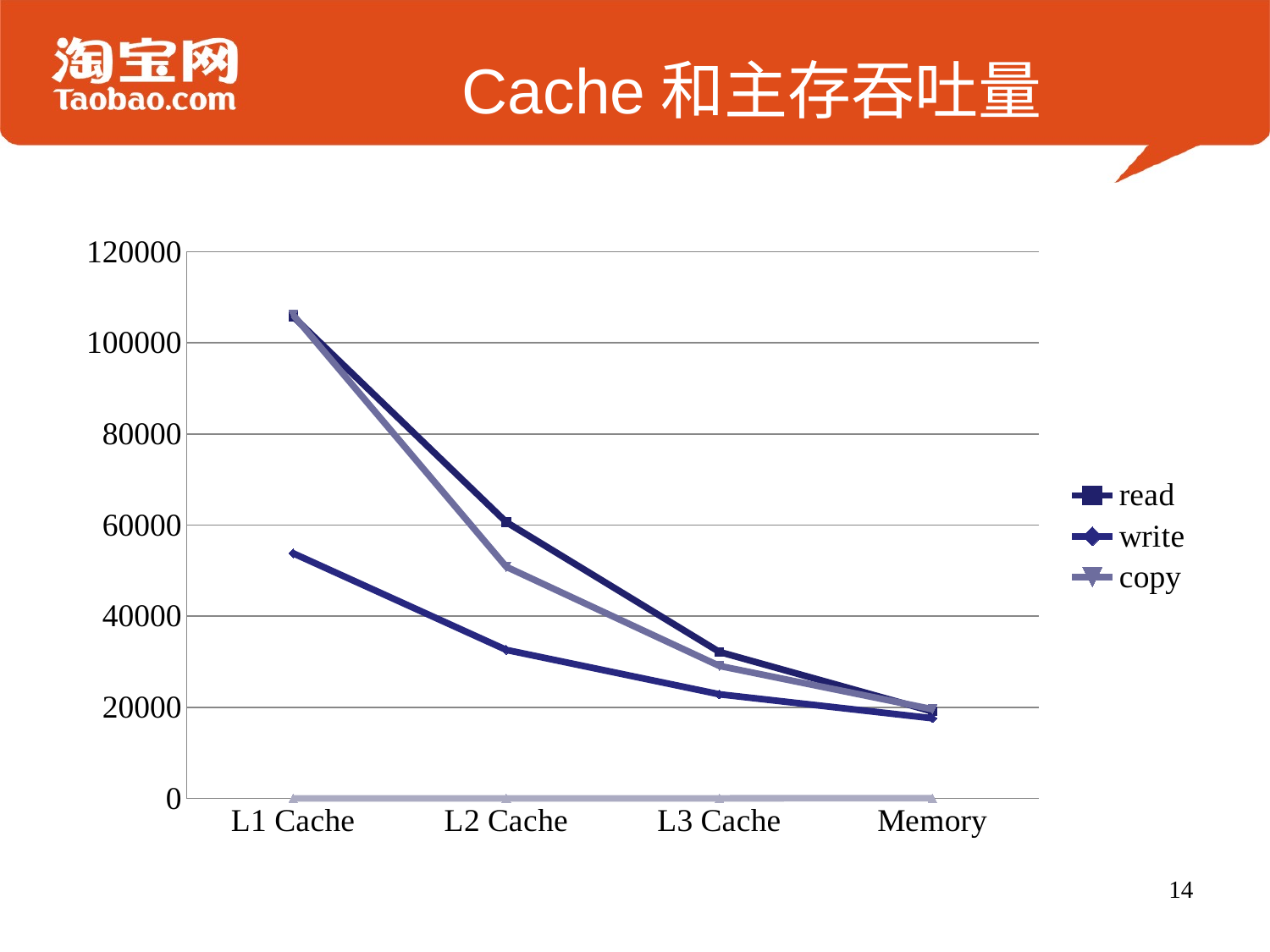
What are the names of the series listed in the legend? read, write, copy Which category has the highest value for the read series? L1 Cache Is the read value for L3 Cache greater or less than 40000? less Is the copy value for L2 Cache greater or less than 40000? greater Which category has the lowest value for the write series? Memory How many categories are shown on the x axis? 4 At L2 Cache, which is larger, the read value or the write value? read Is the read value for L1 Cache greater or less than 100000? greater How many series does the legend list? 3 Do the read values rise or fall from L1 Cache to Memory? fall What kind of chart is shown on the slide? line chart